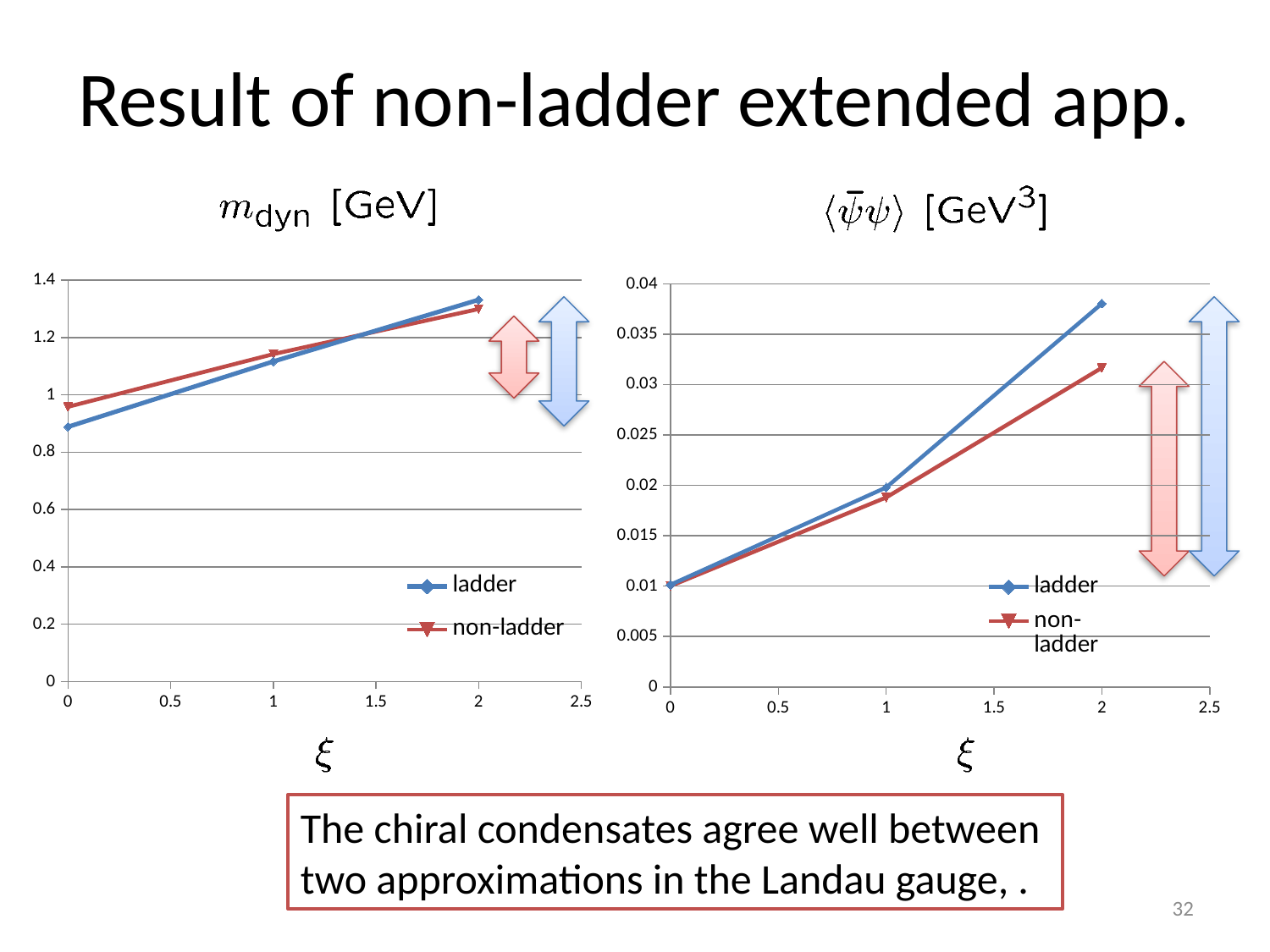
On the left chart (m_dyn [GeV]), how many series does the legend list? 2 On the right chart (chiral condensate [GeV^3]), what are the two legend entries? ladder and non-ladder On the left chart (m_dyn [GeV]), what kind of chart is shown? line chart On the left chart (m_dyn [GeV]), does the ladder series rise or fall as ξ increases? rise On the left chart (m_dyn [GeV]), at ξ = 0, which series has the larger value, ladder or non-ladder? non-ladder On the right chart (chiral condensate [GeV^3]), is the non-ladder value at ξ = 2 greater or less than 0.035? less On the left chart (m_dyn [GeV]), is the ladder value at ξ = 0 greater or less than 1? less On the right chart (chiral condensate [GeV^3]), how many data points does the ladder series have? 3 On the right chart (chiral condensate [GeV^3]), at ξ = 2, which series has the larger value, ladder or non-ladder? ladder On the right chart (chiral condensate [GeV^3]), does the non-ladder series rise or fall as ξ increases? rise On the left chart (m_dyn [GeV]), is the non-ladder value at ξ = 2 greater or less than 1.2? greater